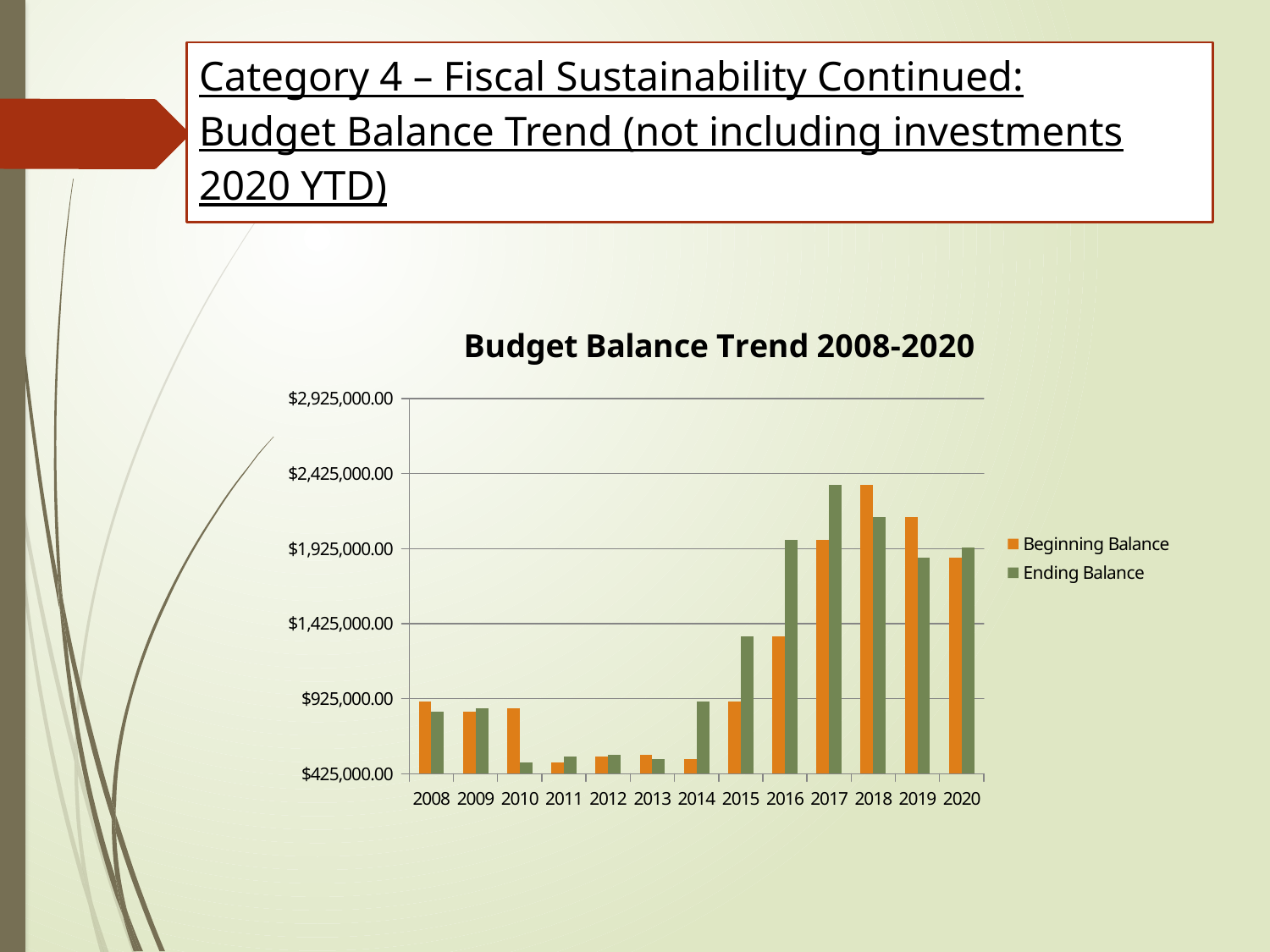
How many series does the legend list? 2 Is the Beginning Balance for 2016 greater or less than $1,425,000.00? less Is the Beginning Balance for 2011 greater or less than $925,000.00? less In 2019, which is larger, the Beginning Balance or the Ending Balance? Beginning Balance What is the title of the chart? Budget Balance Trend 2008-2020 How many years are shown on the x axis? 13 In 2016, which is larger, the Beginning Balance or the Ending Balance? Ending Balance Is the Ending Balance for 2017 greater or less than $1,925,000.00? greater Which year has the highest Ending Balance? 2017 What kind of chart is shown on the slide? bar chart Does the Ending Balance rise or fall from 2017 to 2020? fall Which year has the highest Beginning Balance? 2018